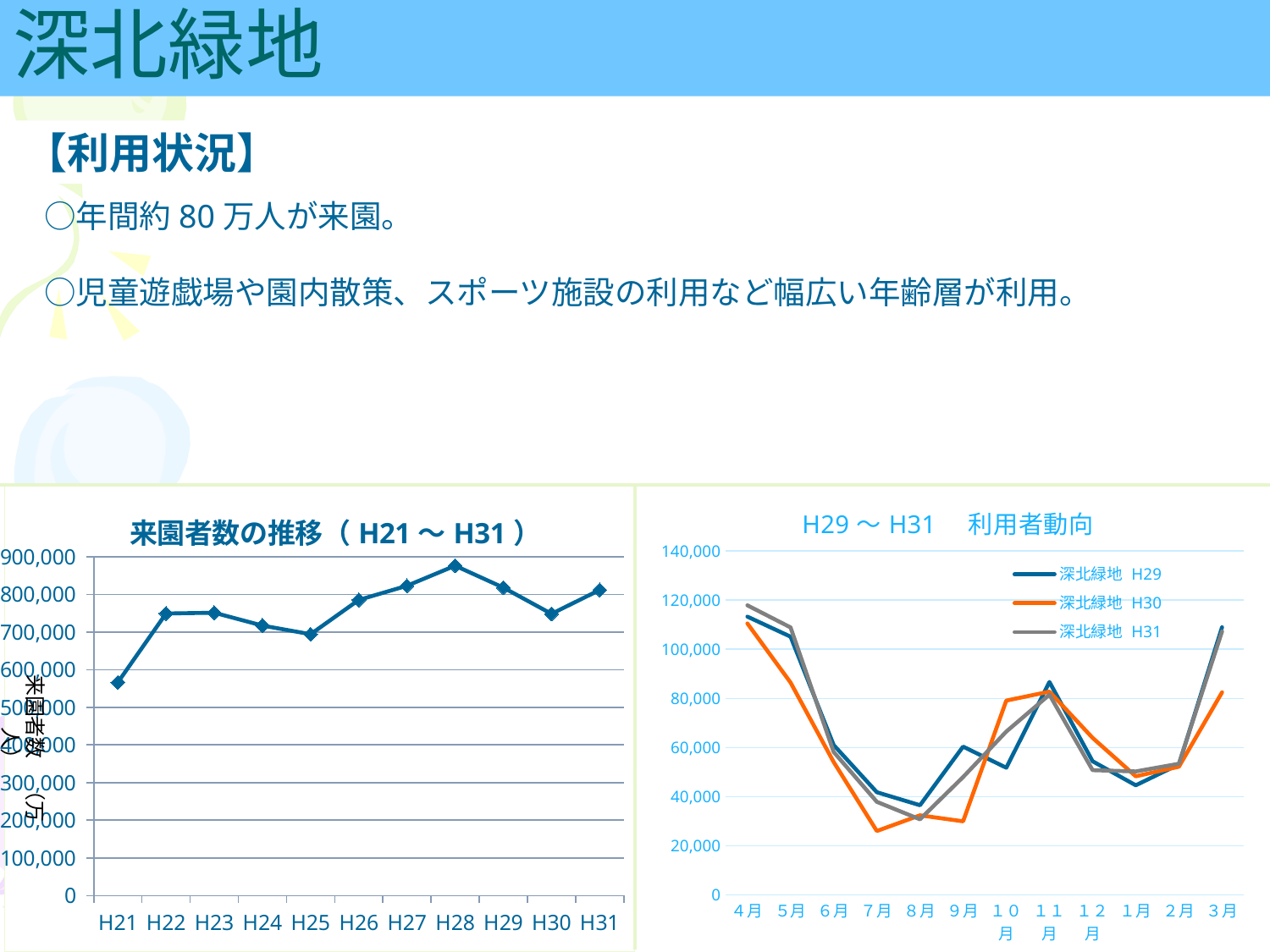
On the right chart (H29～H31 利用者動向), is the value for 深北緑地 H30 in 7月 greater or less than 40,000? less On the left chart (来園者数の推移), which year has the highest number of visitors? H28 On the left chart (来園者数の推移), is the value for H21 greater or less than 600,000? less On the left chart (来園者数の推移), what kind of chart is it? line chart On the right chart (H29～H31 利用者動向), how many months are plotted on the x axis? 12 On the left chart (来園者数の推移), is the value for H27 greater or less than 800,000? greater On the right chart (H29～H31 利用者動向), how many series does the legend list? 3 On the right chart (H29～H31 利用者動向), in 9月, which is larger, the value for 深北緑地 H29 or 深北緑地 H30? 深北緑地 H29 On the left chart (来園者数の推移), which year has the lowest number of visitors? H21 On the left chart (来園者数の推移), how many years are plotted on the x axis? 11 On the left chart (来園者数の推移), which is larger, the value for H28 or the value for H30? H28